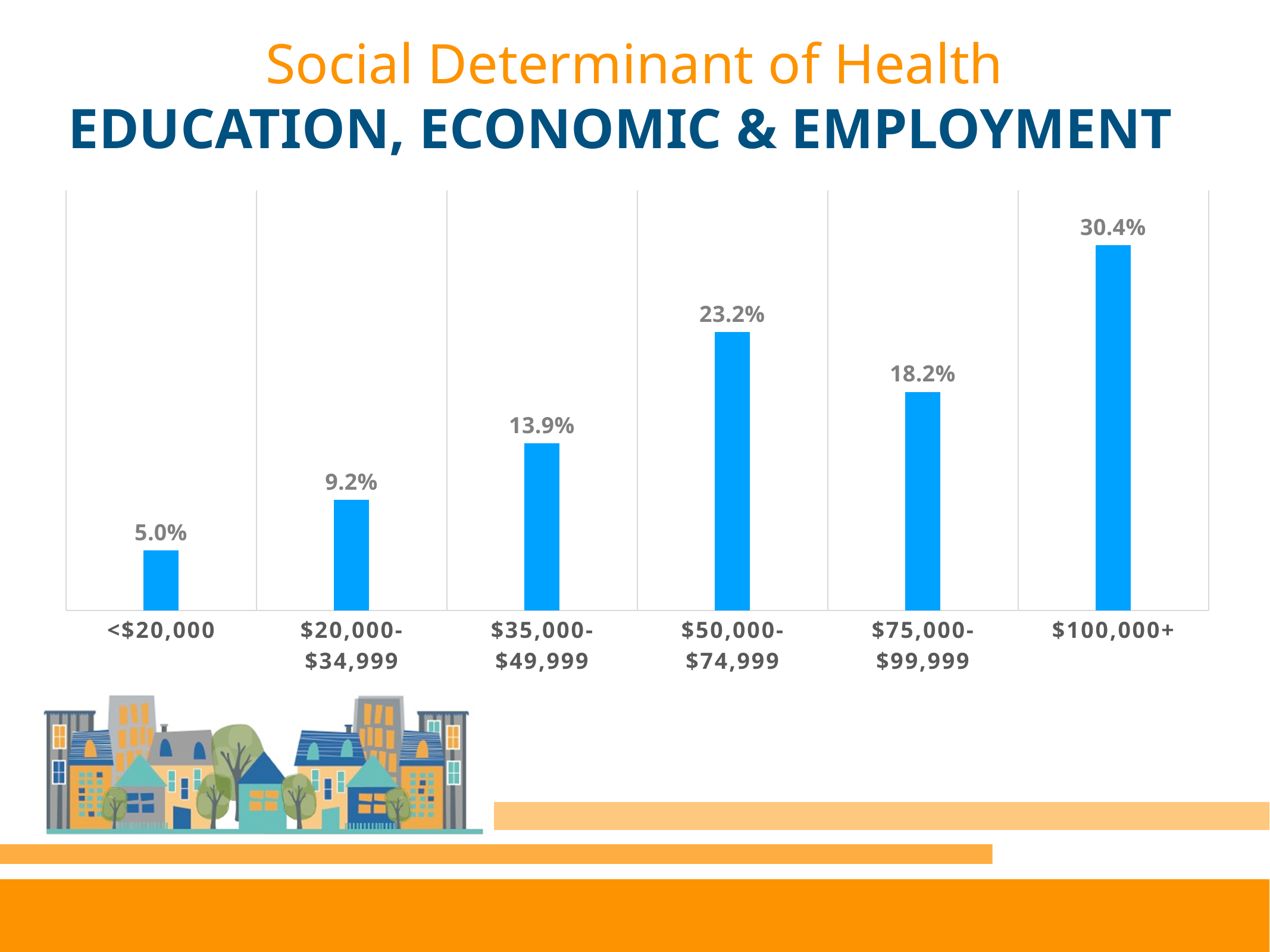
Which is larger, the value for $50,000-$74,999 or the value for $75,000-$99,999? $50,000-$74,999 What is the difference between the values for $50,000-$74,999 and $20,000-$34,999? 14.0% What is the value for the $75,000-$99,999 category? 18.2% Which income category has the lowest value? <$20,000 What is the value for the <$20,000 category? 5.0% What is the value for the $35,000-$49,999 category? 13.9% What kind of chart is shown on the slide? Bar chart What colour are the bars in the chart? Blue How many income categories are shown in the chart? 6 What is the difference between the values for $100,000+ and $75,000-$99,999? 12.2% Which income category has the highest value? $100,000+ What is the value for the $100,000+ category? 30.4%